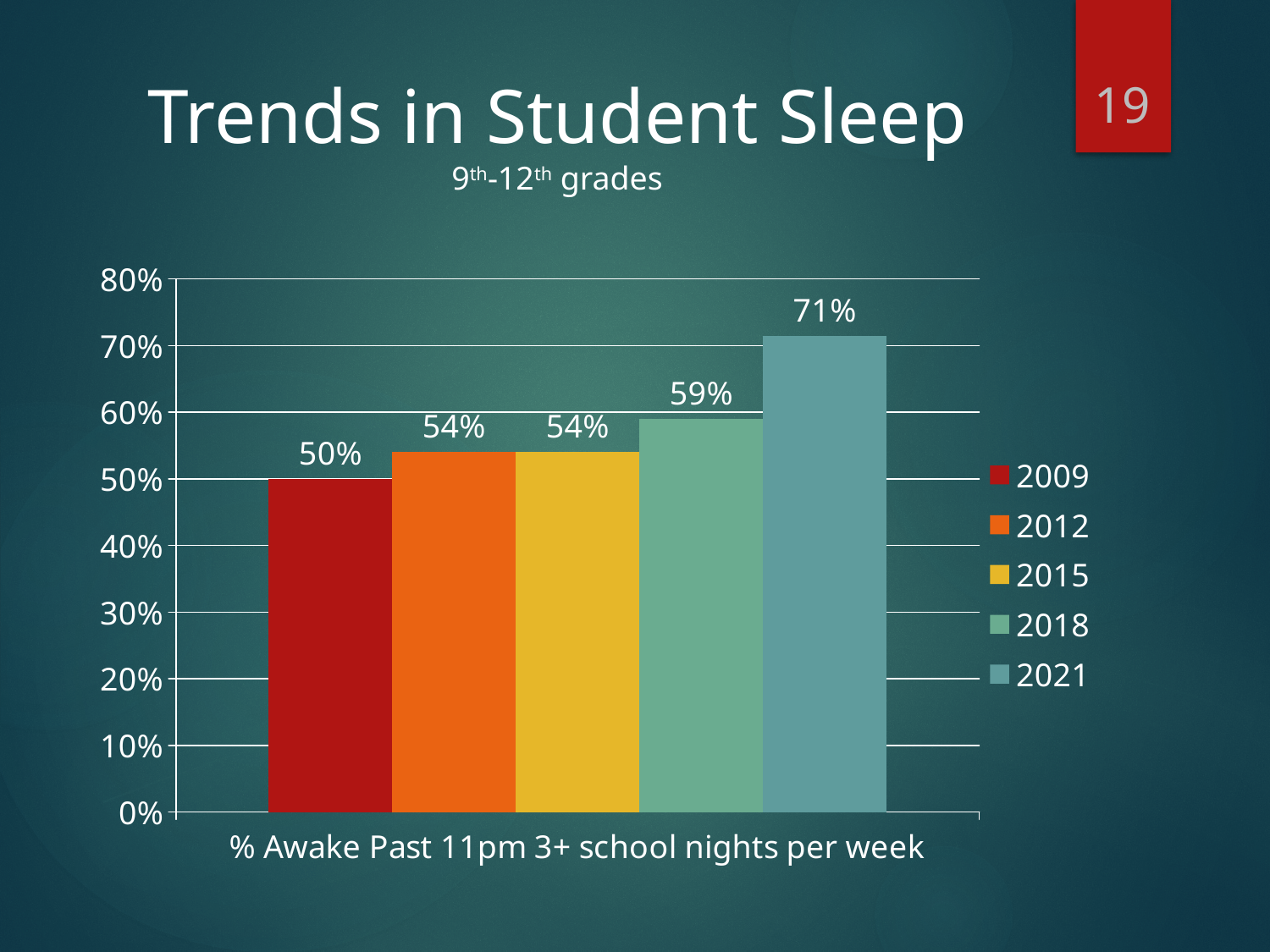
Which year has the lowest percentage of students awake past 11pm 3+ school nights per week? 2009 What is the label shown beneath the bars on the x axis? % Awake Past 11pm 3+ school nights per week Which is larger, the value for 2018 or the value for 2012? 2018 Do the values rise or fall from 2009 to 2021? Rise Which year has the highest percentage of students awake past 11pm 3+ school nights per week? 2021 What percentage of students were awake past 11pm 3+ school nights per week in 2009? 50% What is the value shown for 2021? 71% What is the value shown for 2018? 59% What is the difference between the 2018 value and the 2015 value? 5% What is the difference between the 2021 value and the 2009 value? 21% How many series does the legend list? 5 What kind of chart is shown on the slide? Bar chart